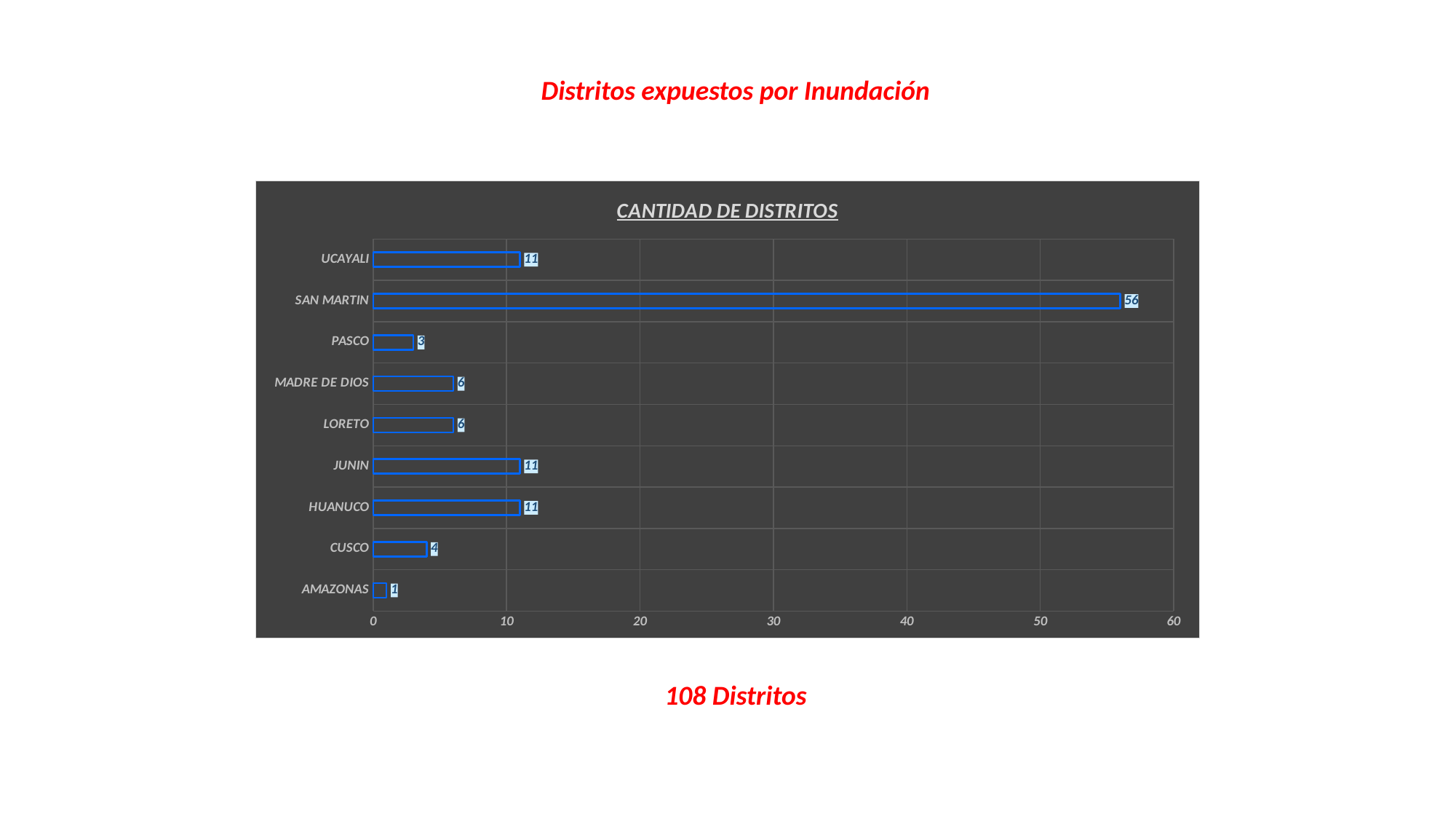
Which category has the highest value? SAN MARTIN What is the value for CUSCO? 4 Which is larger, the value for PASCO or the value for CUSCO? CUSCO What kind of chart is shown? bar chart What is the title of the chart? CANTIDAD DE DISTRITOS How many categories are shown on the chart? 9 What is the difference between the values for SAN MARTIN and UCAYALI? 45 What is the value for MADRE DE DIOS? 6 Which category has the lowest value? AMAZONAS What is the value for SAN MARTIN? 56 What is the difference between the values for JUNIN and LORETO? 5 Is the value for SAN MARTIN greater or less than 50? greater